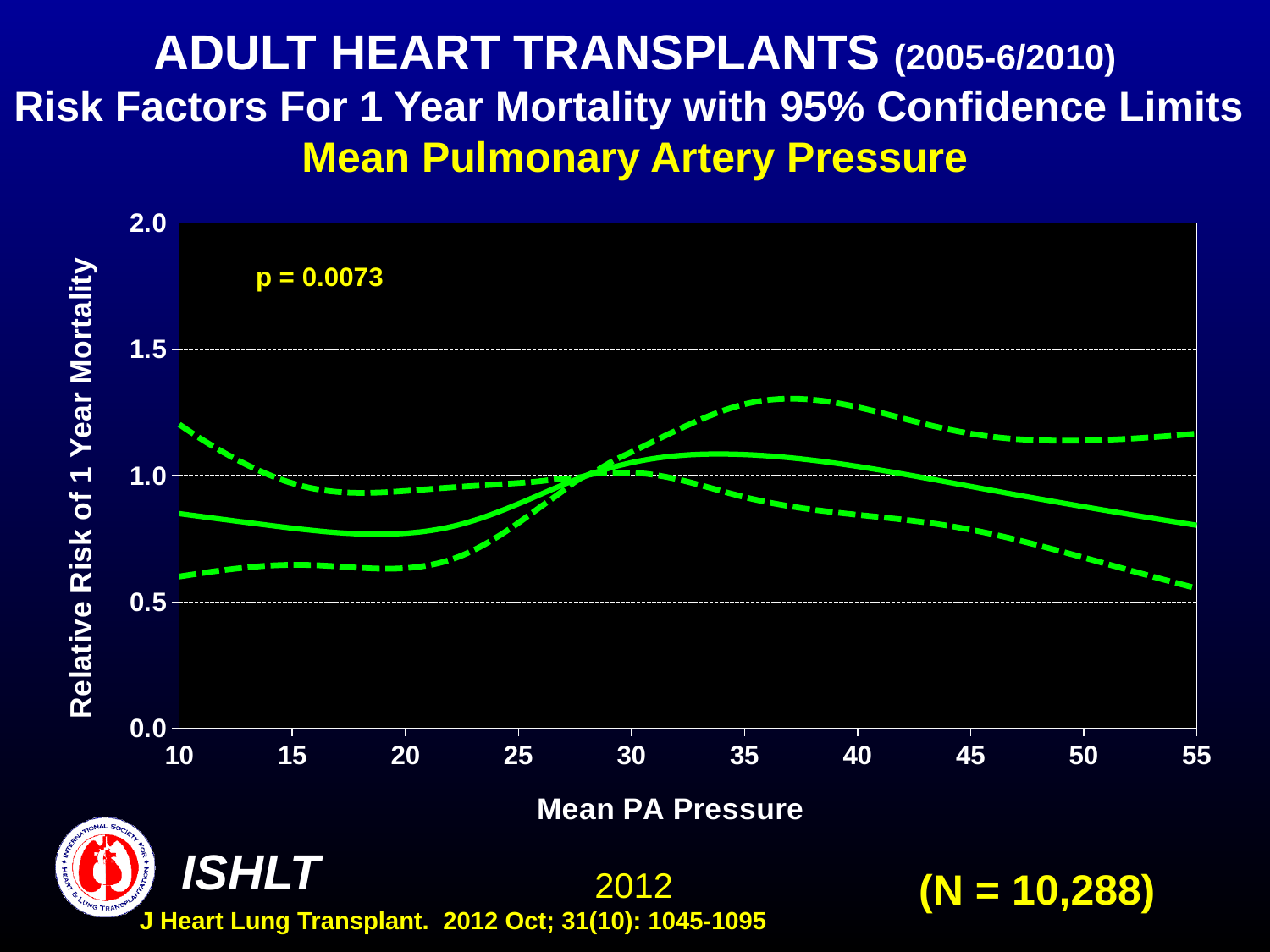
Does the relative risk (solid line) rise or fall as mean PA pressure increases from 20 to 35? rise What is the label of the x axis? Mean PA Pressure Is the lower confidence limit (lower dashed line) at a mean PA pressure of 10 greater or less than 0.5? greater What is the p-value printed on the chart? p = 0.0073 Does the relative risk (solid line) rise or fall as mean PA pressure increases from 35 to 55? fall What kind of chart is shown on the slide? Line chart How many lines are plotted on the chart? 3 Is the upper confidence limit (upper dashed line) at a mean PA pressure of 35 greater or less than 1.5? less Is the relative risk (solid line) at a mean PA pressure of 10 greater or less than 1.0? less What is the highest value shown on the y axis? 2.0